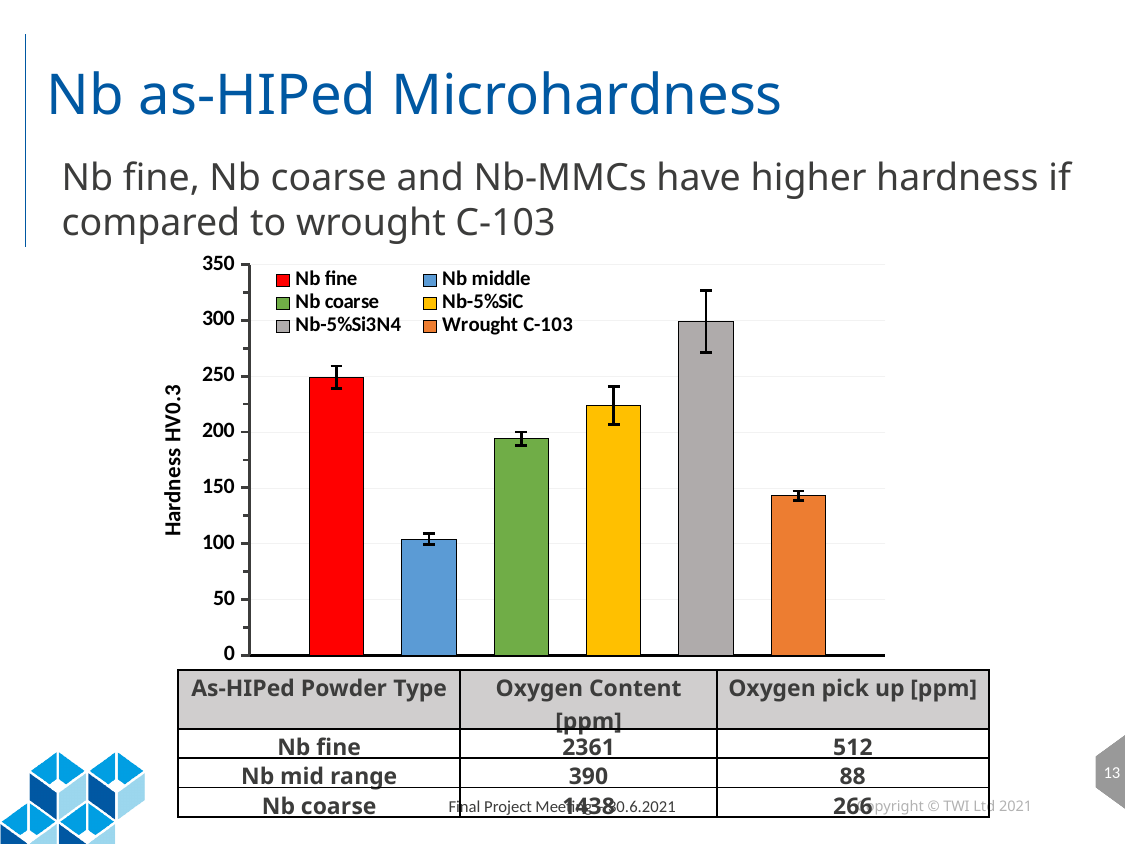
Is the hardness value for Nb fine greater or less than 200? greater Is the hardness value for Wrought C-103 greater or less than 200? less Which has the higher hardness, Nb-5%SiC or Wrought C-103? Nb-5%SiC How many bars are plotted in the chart? 6 Is the hardness value for Nb middle greater or less than 150? less Which material has the highest hardness in the chart? Nb-5%Si3N4 How many series does the chart legend list? 6 Which material has the lowest hardness in the chart? Nb middle Which has the higher hardness, Nb fine or Nb coarse? Nb fine What kind of chart is shown on the slide? bar chart What is the label of the vertical axis of the chart? Hardness HV0.3